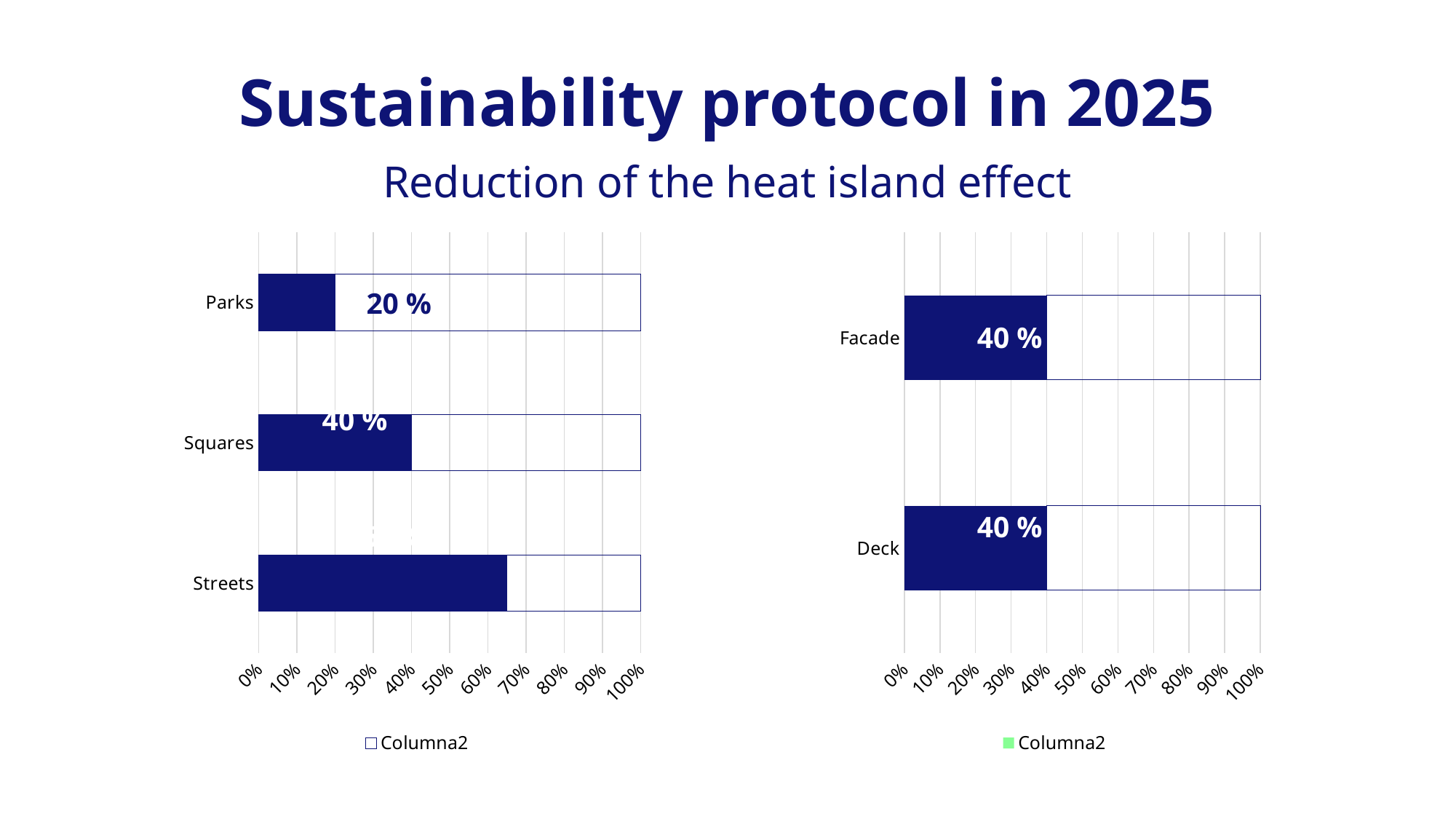
In the left chart, what is the value for Squares? 40 % In the left chart, what is the difference between the values for Squares and Parks? 20 % In the right chart, what is the value for Facade? 40 % In the left chart, is the value for Streets greater or less than 50%? greater How many categories are shown in the right chart? 2 In the left chart, what is the value for Parks? 20 % In the right chart, what is the value for Deck? 40 % In the left chart, which category has the highest value? Streets What kind of chart is the left chart? bar chart In the left chart, which is larger, the value for Parks or the value for Squares? Squares How many categories are shown in the left chart? 3 In the left chart, which category has the lowest value? Parks